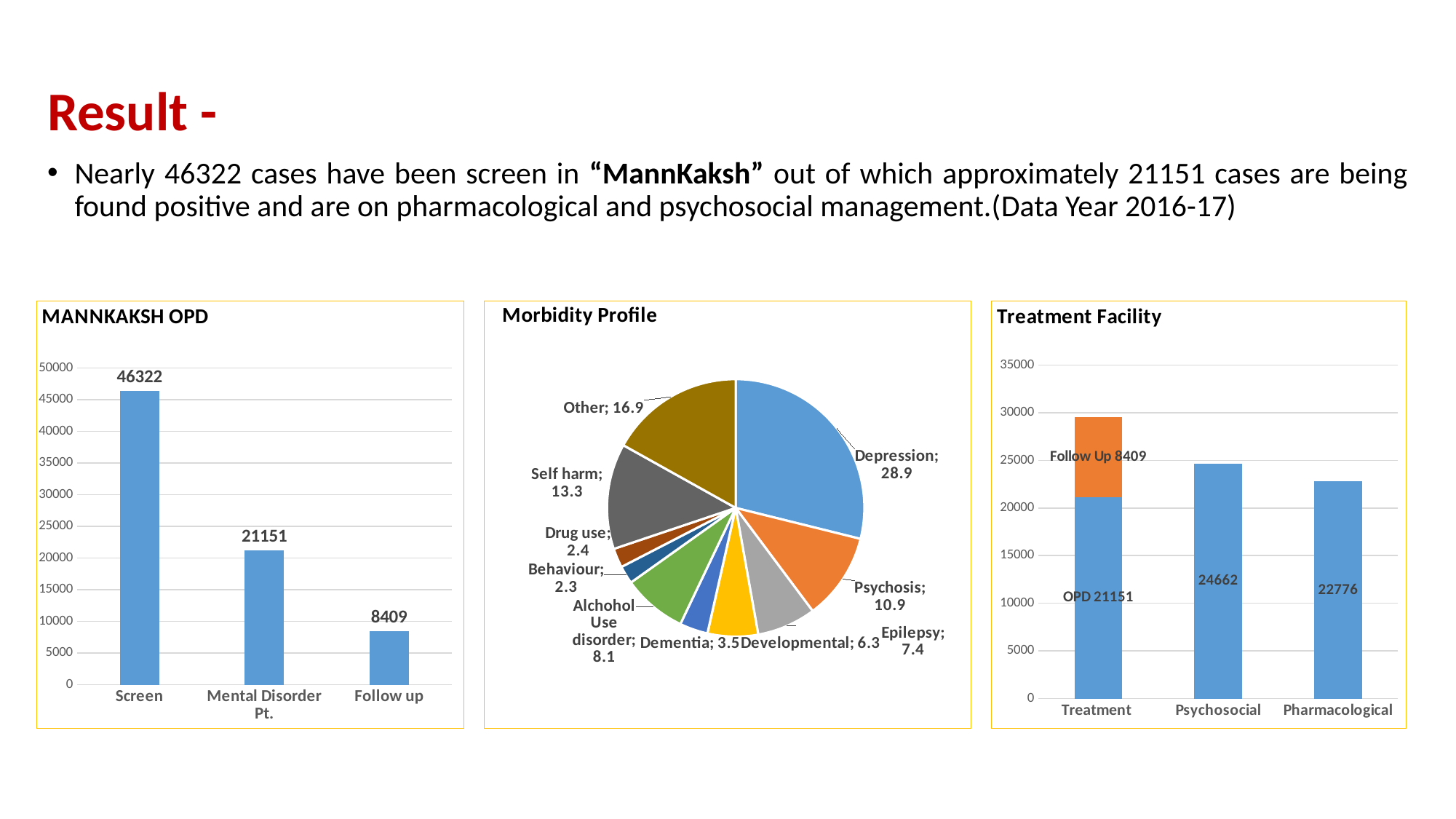
What kind of chart is the Morbidity Profile chart? Pie chart In the MANNKAKSH OPD chart, what is the value for Follow up? 8409 In the MANNKAKSH OPD chart, what is the difference between Screen and Mental Disorder Pt.? 25171 In the Morbidity Profile chart, which slice is the largest? Depression In the Morbidity Profile chart, what is the value for Depression? 28.9 In the Treatment Facility chart, which is larger, Psychosocial or Pharmacological? Psychosocial In the MANNKAKSH OPD chart, how many categories are shown on the x axis? 3 In the Morbidity Profile chart, what is the value for Self harm? 13.3 In the MANNKAKSH OPD chart, what is the value for Screen? 46322 In the Treatment Facility chart, what is the total of the stacked Treatment bar? 29560 In the Treatment Facility chart, what is the value for Pharmacological? 22776 In the MANNKAKSH OPD chart, which category has the lowest value? Follow up